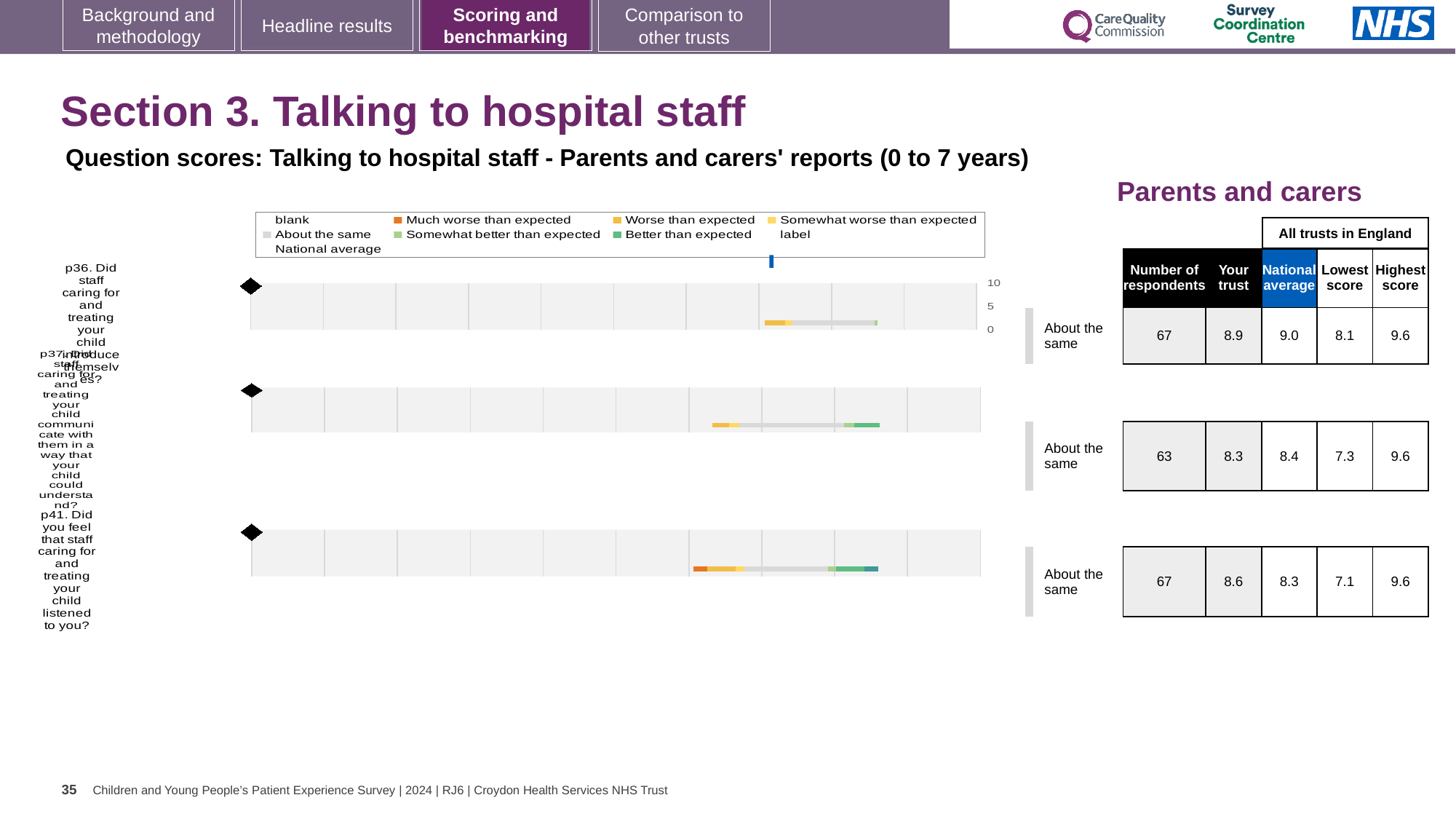
What is the highest score among all trusts in England for p36? 9.6 What is the national average score for p41 (Did you feel that staff caring for and treating your child listened to you)? 8.3 For p37, which is larger: the 'Your trust' score or the national average? National average Which question has the highest 'Your trust' score? p36 How many survey questions (chart rows) are plotted on the slide? 3 Which question has the lowest 'Lowest score' across all trusts in England? p41 What is the 'Your trust' score for p36 (Did staff caring for and treating your child introduce themselves)? 8.9 For p41, what is the difference between the 'Your trust' score and the national average? 0.3 What kind of chart is used to show the benchmark ranges for each question? Bar chart What benchmark category is shown for p36? About the same How many respondents answered p37 (Did staff communicate with them in a way that your child could understand)? 63 What is the maximum value shown on the chart's score axis? 10